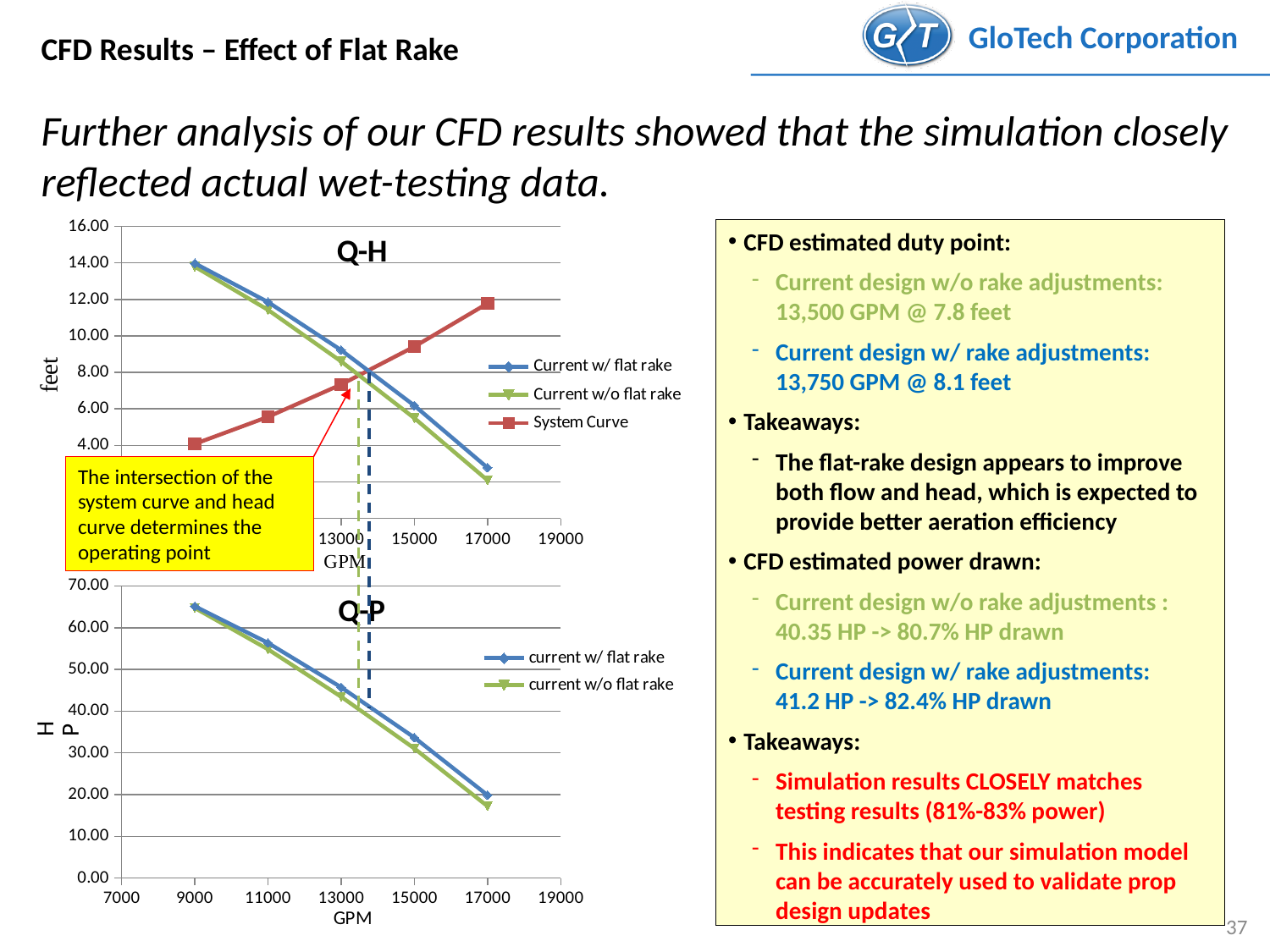
In the Q-H chart, is the Current w/ flat rake value at 17000 GPM greater or less than 4.00 feet? less What type of chart is the Q-H chart? line chart In the Q-P chart, do the current w/ flat rake values rise or fall as GPM increases? fall In the Q-H chart, does the System Curve rise or fall as GPM increases? rise How many series does the legend of the Q-P chart list? 2 In the Q-H chart, is the System Curve value at 17000 GPM greater or less than 10.00 feet? greater In the Q-H chart, at 17000 GPM, which is higher: the System Curve or Current w/ flat rake? System Curve In the Q-H chart, how many data points does the System Curve series have? 5 In the Q-P chart, is the current w/o flat rake value at 17000 GPM greater or less than 20.00 HP? less What is the x-axis label of the Q-P chart? GPM How many series does the legend of the Q-H chart list? 3